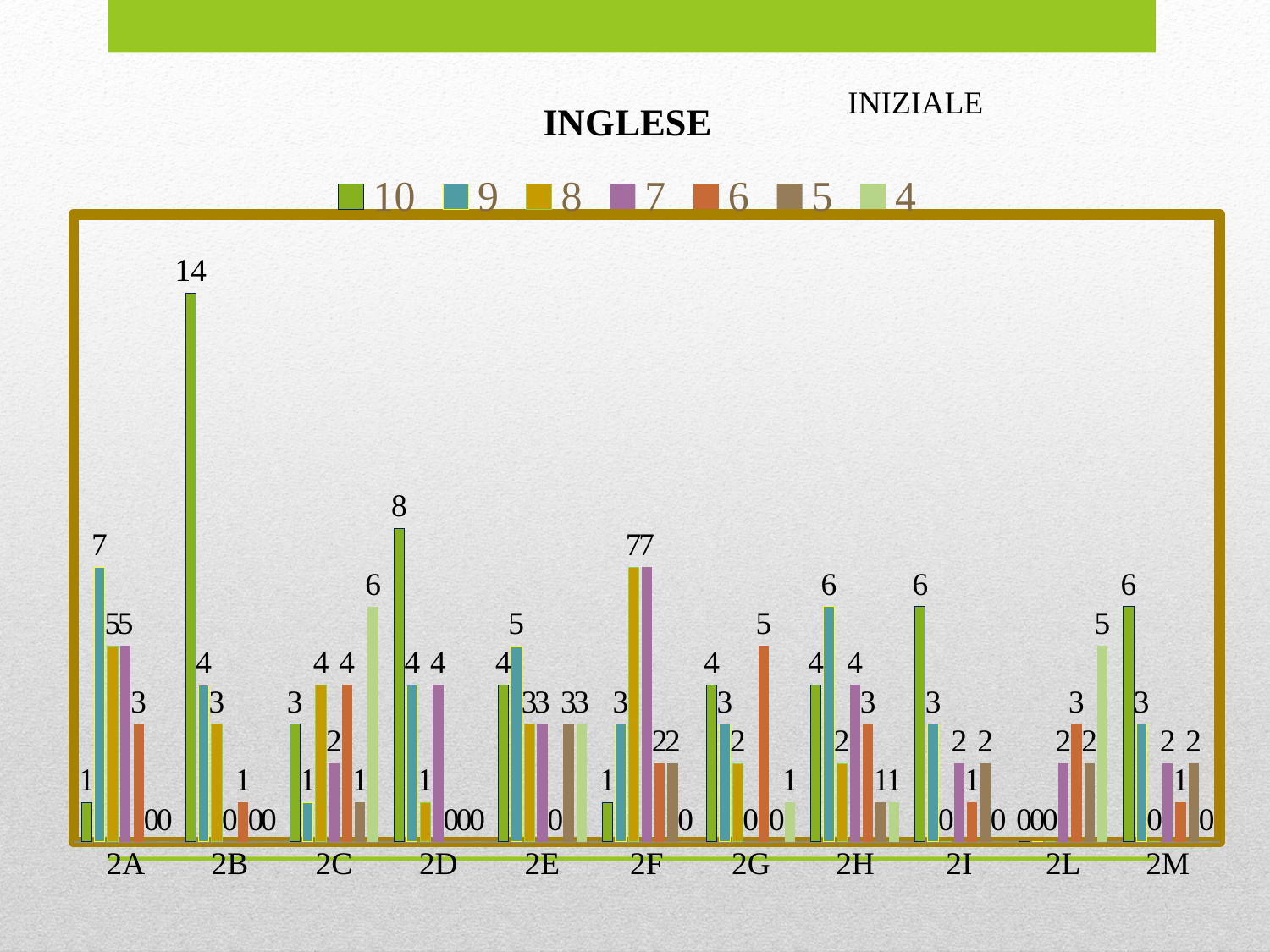
Which category has the highest value for series 10? 2B What is the difference between the series 10 values for 2B and 2D? 6 What is the value of series 4 for category 2C? 6 How many categories are shown on the x axis? 11 What is the value of series 9 for category 2A? 7 How many series does the legend list? 7 What is the value of series 10 for category 2D? 8 Which is larger: the series 9 value for 2A or the series 9 value for 2H? 2A What is the value of series 6 for category 2G? 5 What type of chart is shown on the slide? bar chart Which category has the highest value for series 9? 2A What is the value of series 10 for category 2B? 14